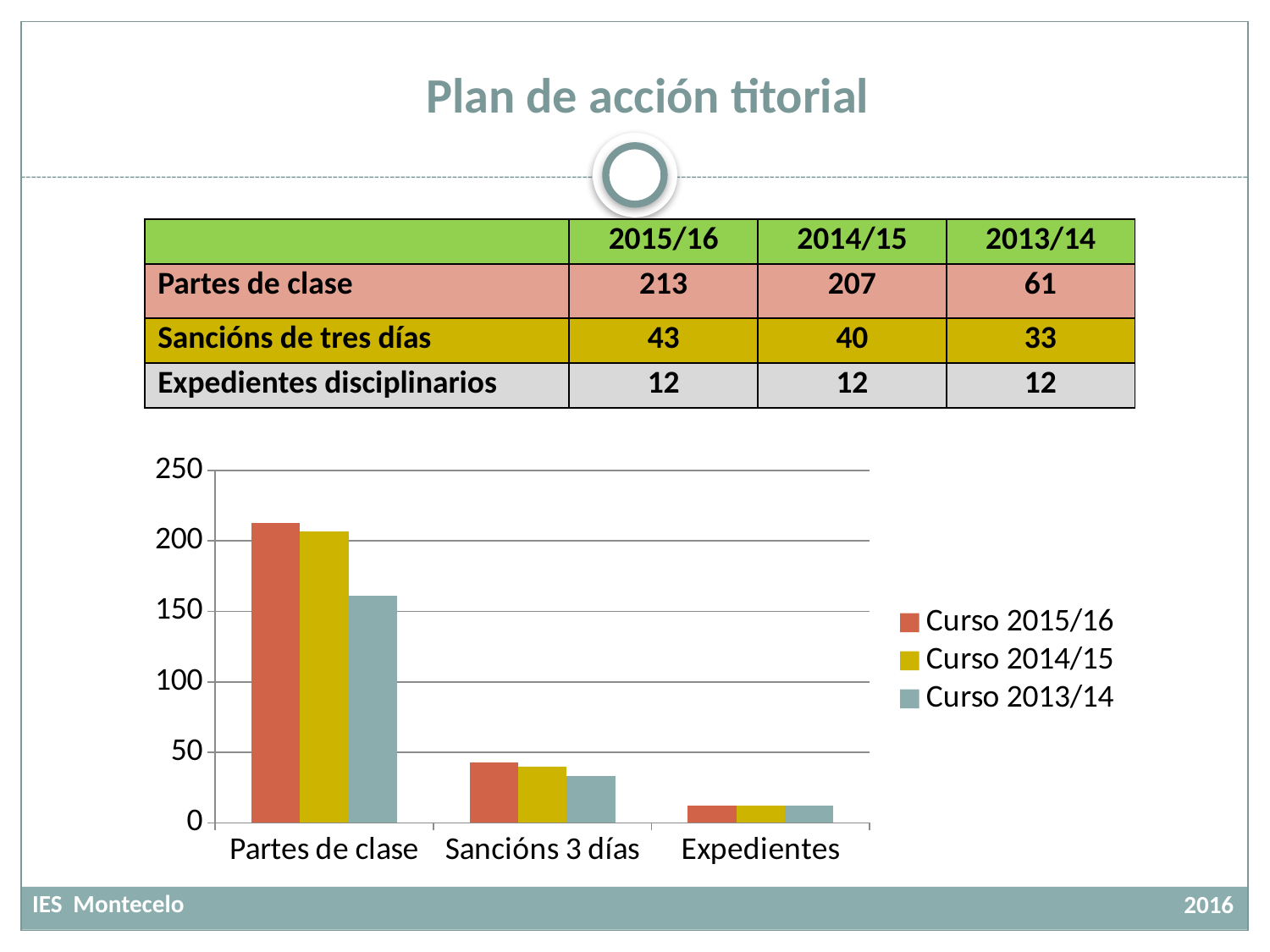
How many categories are shown on the x axis of the chart? 3 Which category has the highest value for Curso 2015/16 in the chart? Partes de clase What kind of chart is shown on the slide? bar chart According to the table, what is the value of Partes de clase for 2015/16? 213 Is the value for Sancións 3 días in Curso 2015/16 greater or less than 50 in the chart? less How many series does the chart legend list? 3 According to the table, what is the difference between Sancións de tres días in 2015/16 and 2014/15? 3 For Partes de clase, which is larger in the chart: Curso 2015/16 or Curso 2013/14? Curso 2015/16 Do the values for Curso 2015/16 rise or fall from left to right across the categories in the chart? fall Which category has the lowest value for Curso 2014/15 in the chart? Expedientes Is the value for Partes de clase in Curso 2013/14 greater or less than 150 in the chart? greater According to the table, what is the value of Sancións de tres días for 2013/14? 33